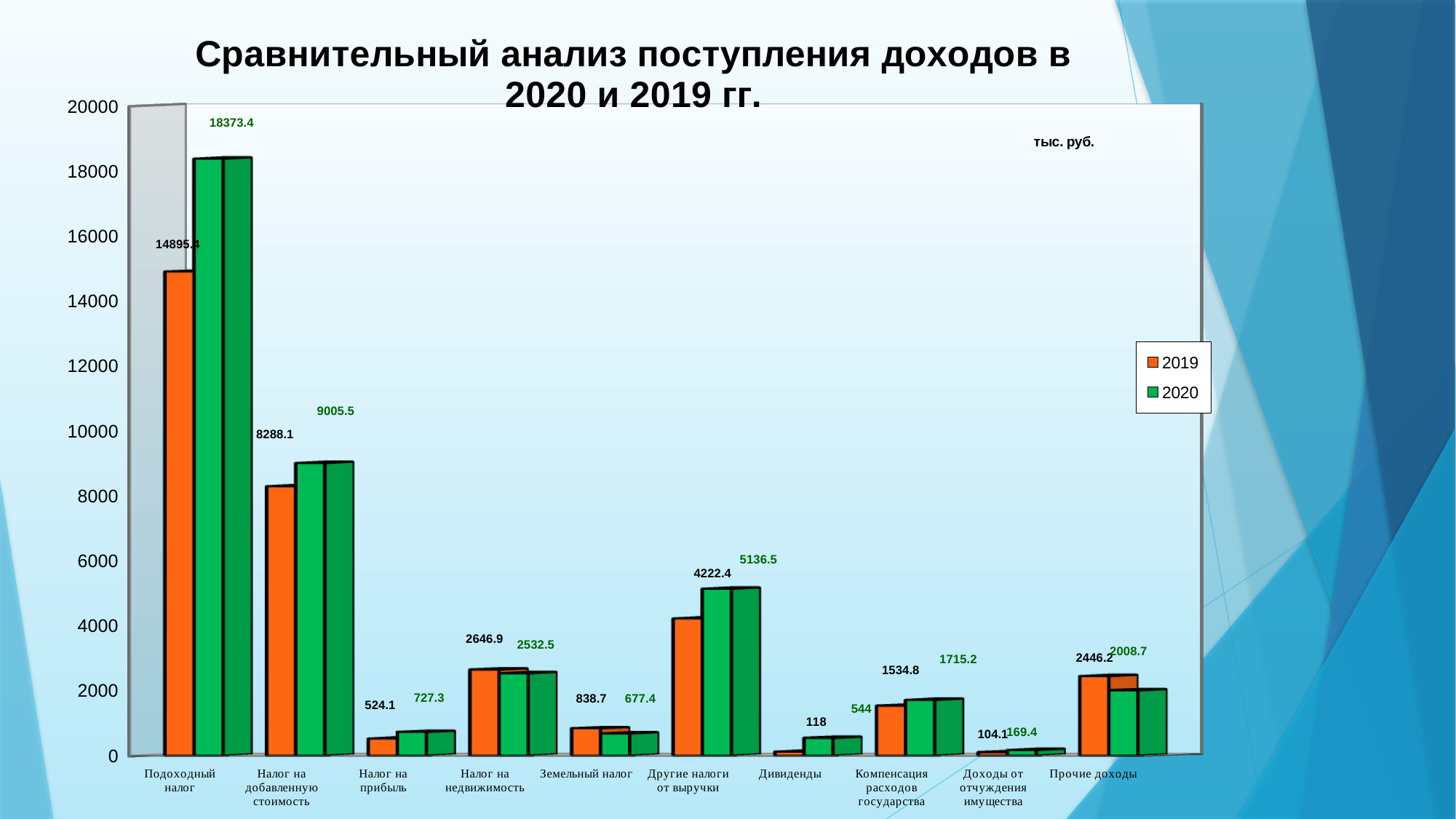
What unit is indicated on the chart? тыс. руб. What is the value for Доходы от отчуждения имущества in 2019? 104.1 How many categories are shown on the x axis? 10 Which category has the highest value in 2020? Подоходный налог Which category has the lowest value in 2019? Доходы от отчуждения имущества What is the value for Подоходный налог in 2020? 18373.4 What is the difference between the 2020 and 2019 values for Подоходный налог? 3478 How many series does the legend list? 2 Which is larger for Прочие доходы: the 2019 value or the 2020 value? 2019 What type of chart is shown on the slide? bar chart What is the value for Налог на добавленную стоимость in 2019? 8288.1 What is the value for Другие налоги от выручки in 2020? 5136.5